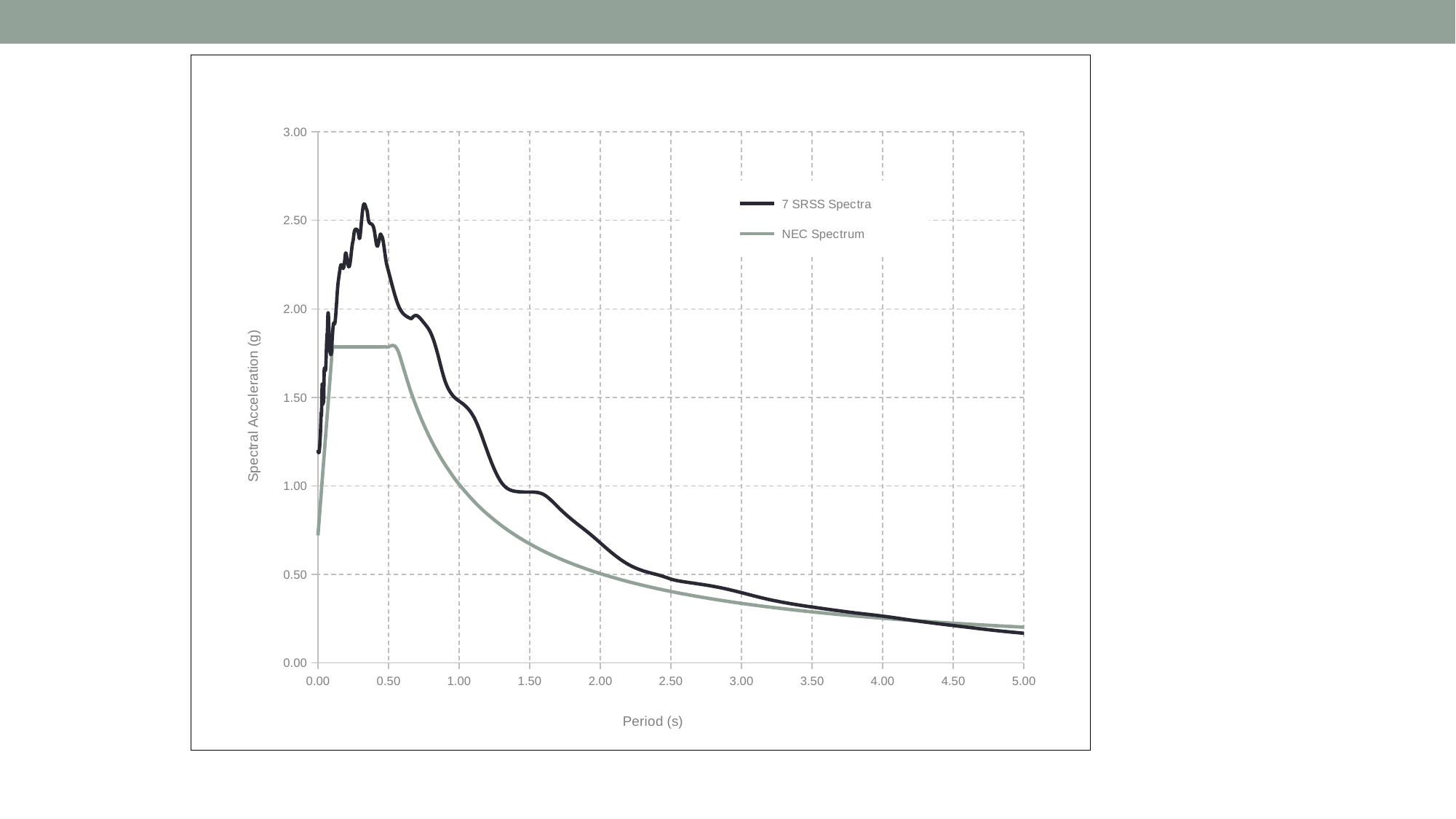
Is the value of the NEC Spectrum series at a period of 3.00 s greater or less than 0.50? less How many series does the legend list? 2 Is the plateau value of the NEC Spectrum series at a period of 0.50 s greater or less than 2.00? less What are the two series named in the legend? 7 SRSS Spectra and NEC Spectrum Which series reaches the higher peak value? 7 SRSS Spectra What kind of chart is shown on the slide? line chart Is the peak value of the 7 SRSS Spectra series greater or less than 2.00? greater At a period of 1.00 s, which series has the higher spectral acceleration? 7 SRSS Spectra What is the label of the x axis? Period (s) Does the NEC Spectrum series rise or fall as the period increases from 0.50 s to 5.00 s? fall Does the 7 SRSS Spectra series rise or fall as the period increases from 1.00 s to 5.00 s? fall